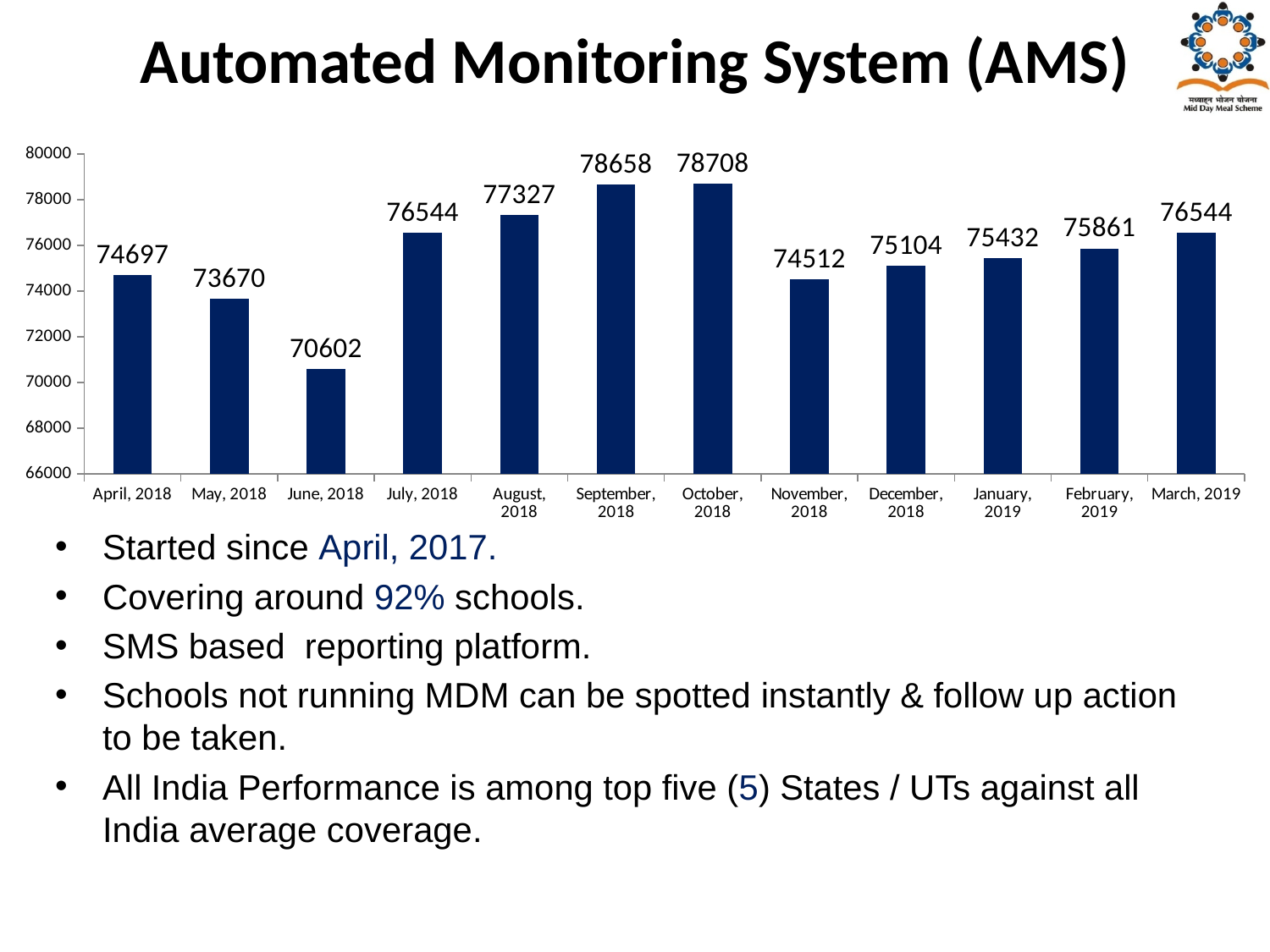
What is the difference between the values for March, 2019 and February, 2019? 683 Which month has the lowest value? June, 2018 Which month has the highest value? October, 2018 What is the value for October, 2018? 78708 What kind of chart is shown on the slide? bar chart What is the difference between the values for October, 2018 and June, 2018? 8106 What is the value for June, 2018? 70602 How many months are shown on the x axis? 12 Do the values rise or fall from November, 2018 to March, 2019? rise What is the value for January, 2019? 75432 Is the value for May, 2018 greater or less than 74000? less Which is larger, the value for April, 2018 or the value for November, 2018? April, 2018